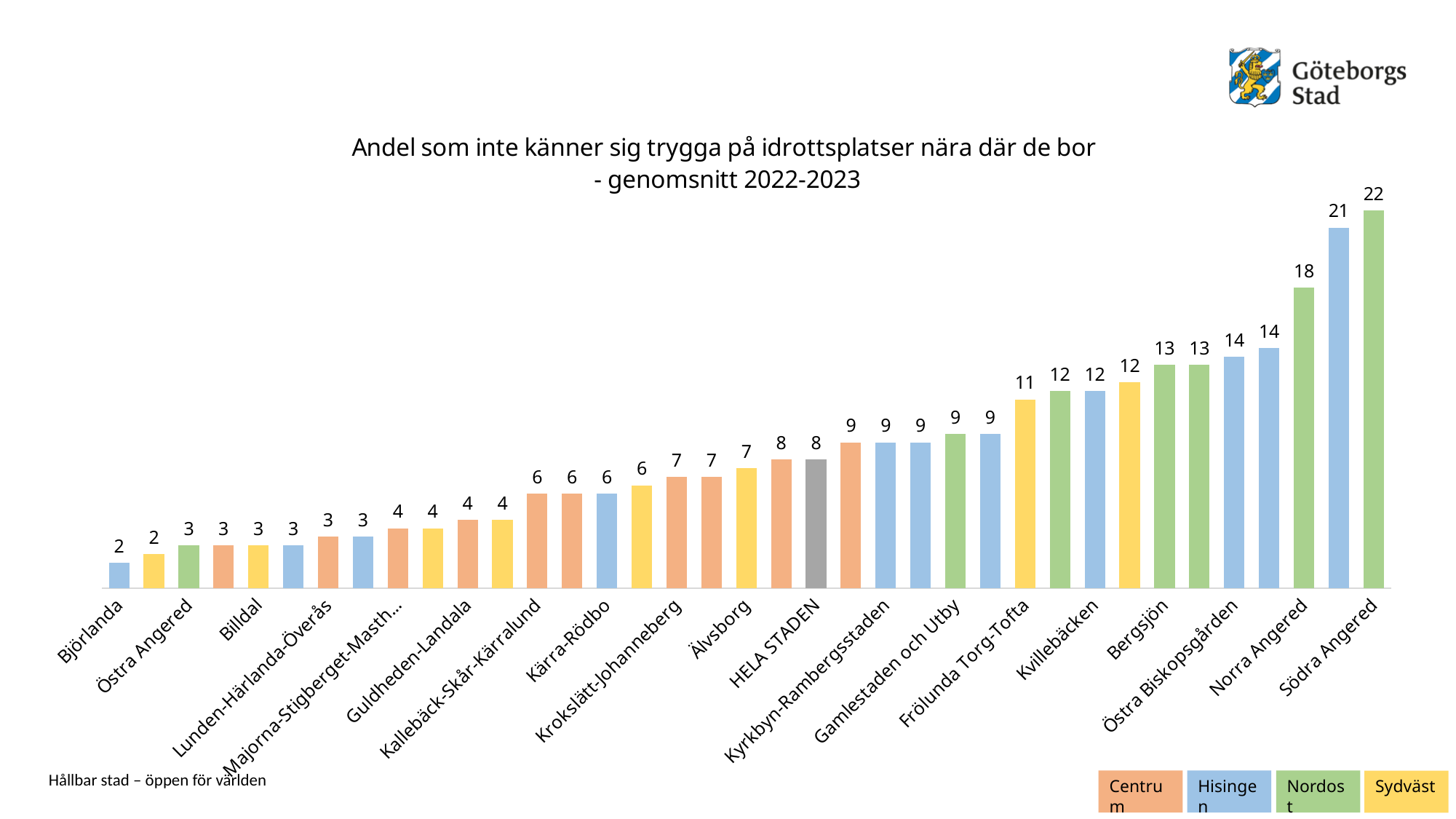
Which has a larger value, Bergsjön or Kvillebäcken? Bergsjön What is the value for Södra Angered? 22 What is the difference between the values for Södra Angered and Björlanda? 20 What is the value for Frölunda Torg-Tofta? 11 How many entries does the legend list? 4 Which category has the highest value? Södra Angered What is the value for Norra Angered? 18 Do the values rise or fall from left to right along the x axis? Rise What is the value for Björlanda? 2 What kind of chart is shown? Bar chart What is the value for HELA STADEN? 8 What is the difference between the values for Norra Angered and HELA STADEN? 10